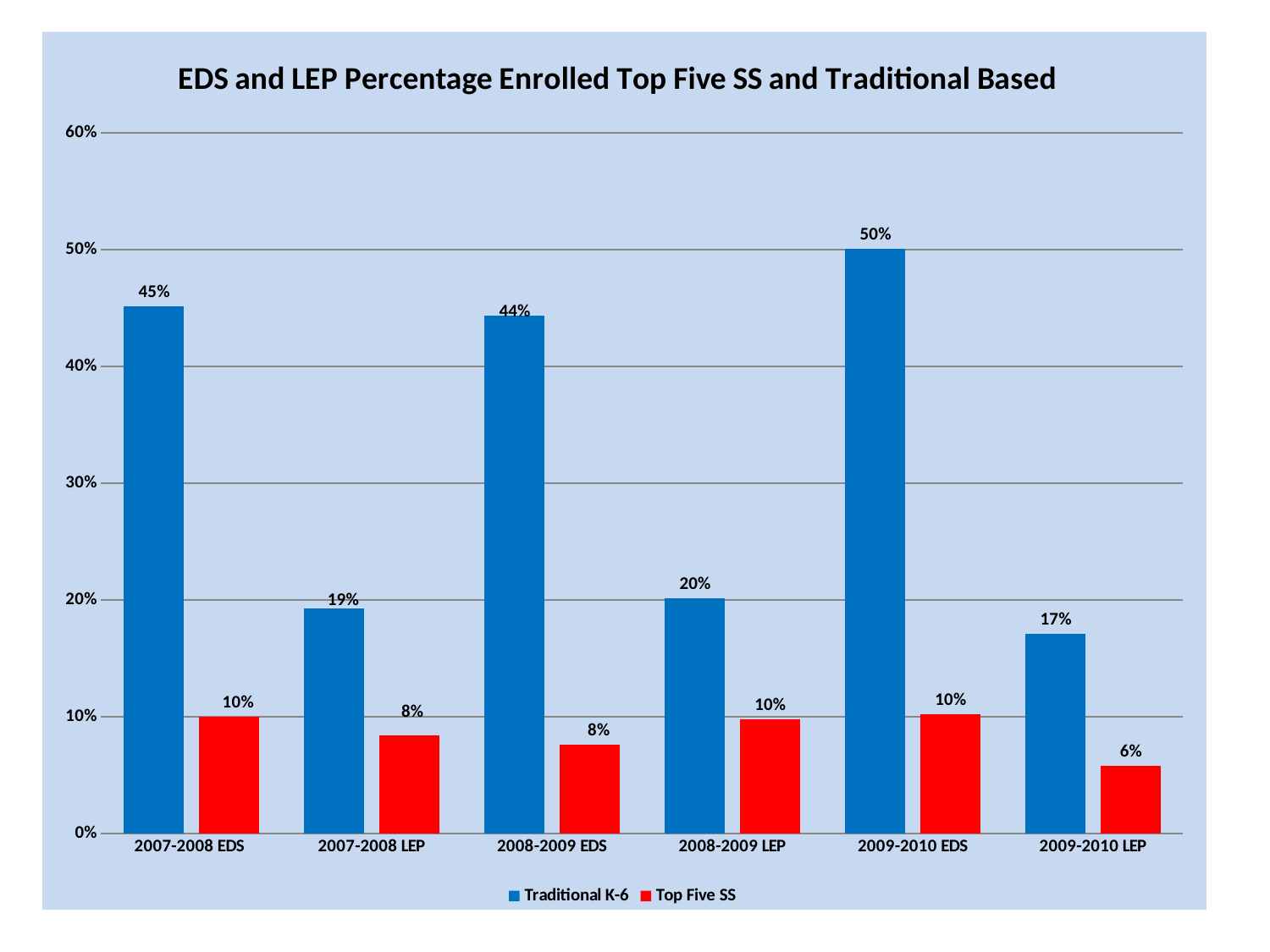
How many categories are shown on the x axis? 6 How many series does the legend list? 2 What colour are the Top Five SS bars? red Is the Traditional K-6 value for 2007-2008 LEP greater or less than 10%? greater What is the difference between the Traditional K-6 and Top Five SS values for 2007-2008 EDS? 35% What is the Traditional K-6 value for 2008-2009 LEP? 20% Which category has the highest Traditional K-6 value? 2009-2010 EDS What is the Traditional K-6 value for 2009-2010 EDS? 50% Which is larger for 2008-2009 LEP: the Traditional K-6 value or the Top Five SS value? Traditional K-6 What kind of chart is shown on the slide? bar chart What is the Top Five SS value for 2009-2010 LEP? 6% Which category has the lowest Top Five SS value? 2009-2010 LEP